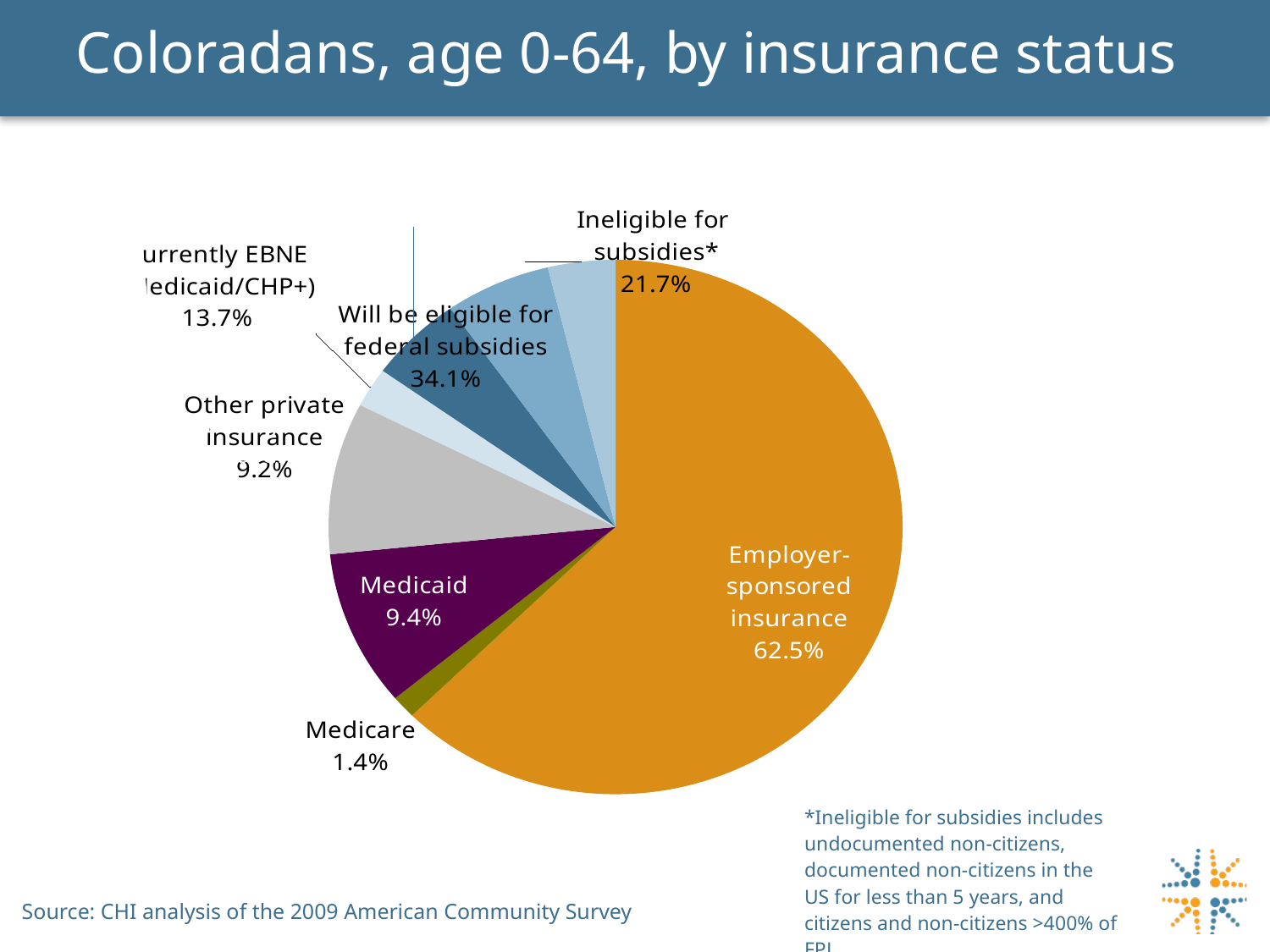
What value is shown for the Medicare slice? 1.4% What value is labelled for 'Ineligible for subsidies*'? 21.7% Which category has the smallest slice of the pie? Medicare What value is shown for the Medicaid slice? 9.4% What kind of chart is shown on the slide? pie chart What is the difference between the Employer-sponsored insurance value and the Medicaid value? 53.1% What percentage of Coloradans age 0-64 have employer-sponsored insurance? 62.5% What is the source cited for the chart? CHI analysis of the 2009 American Community Survey Which is larger, the Medicaid slice or the Medicare slice? Medicaid What value is labelled for 'Will be eligible for federal subsidies'? 34.1% What value is shown for Other private insurance? 9.2% Which category has the largest slice of the pie? Employer-sponsored insurance